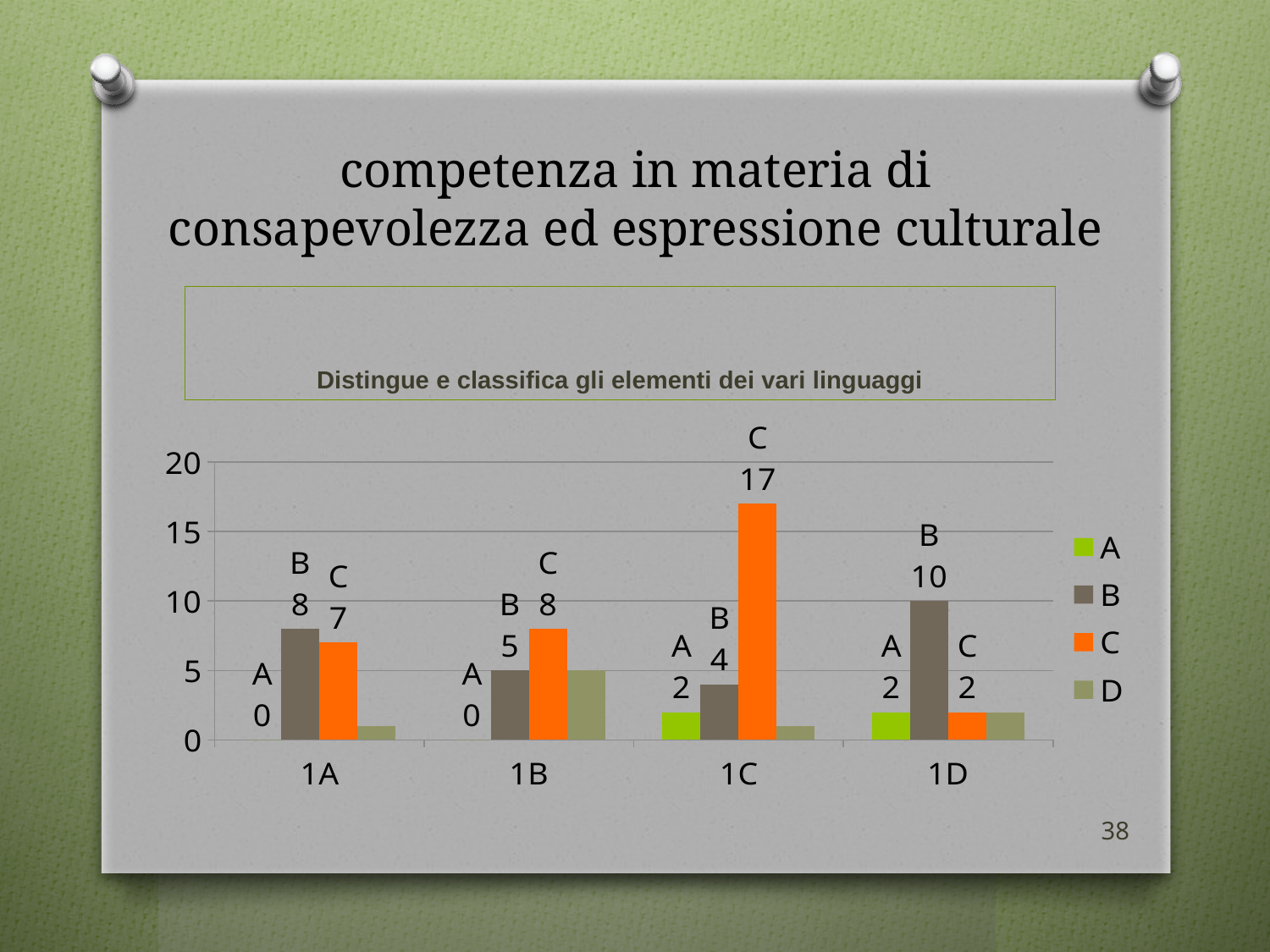
How many categories are shown on the x axis? 4 Which category has the highest value for series C? 1C What kind of chart is shown on the slide? bar chart Which category has the lowest value for series B? 1C Which is larger: the value of series C for 1B or the value of series C for 1A? 1B How many series does the legend list? 4 What is the value of series C for category 1B? 8 Is the value of series D for category 1B greater or less than 10? less What is the value of series A for category 1A? 0 What is the value of series B for category 1D? 10 What is the difference between the value of series B for 1A and the value of series B for 1B? 3 What is the value of series C for category 1C? 17